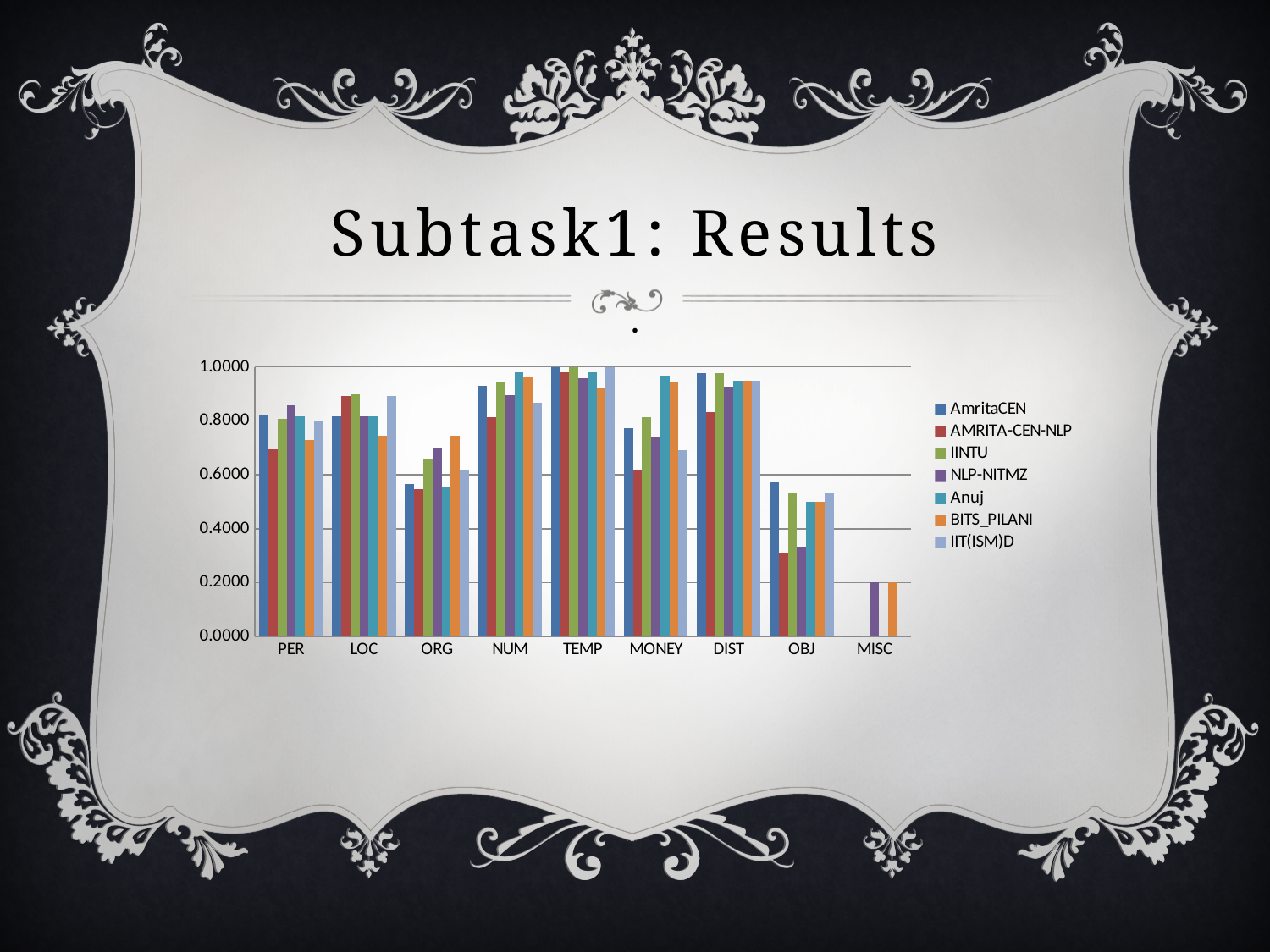
What kind of chart is shown on the slide? bar chart Is the value for BITS_PILANI in the ORG category greater or less than 0.6000? greater Is the value for Anuj in the NUM category greater or less than 0.8000? greater How many series does the chart's legend list? 7 Which series is listed first in the chart's legend? AmritaCEN For the AmritaCEN series, which category has the larger value: TEMP or OBJ? TEMP Which category has the lowest values overall in the chart? MISC How many categories are shown on the x axis of the chart? 9 Is the value for AmritaCEN in the MONEY category greater or less than 0.6000? greater What is the title of the slide containing the chart? Subtask1: Results For the IINTU series, which category has the larger value: ORG or NUM? NUM